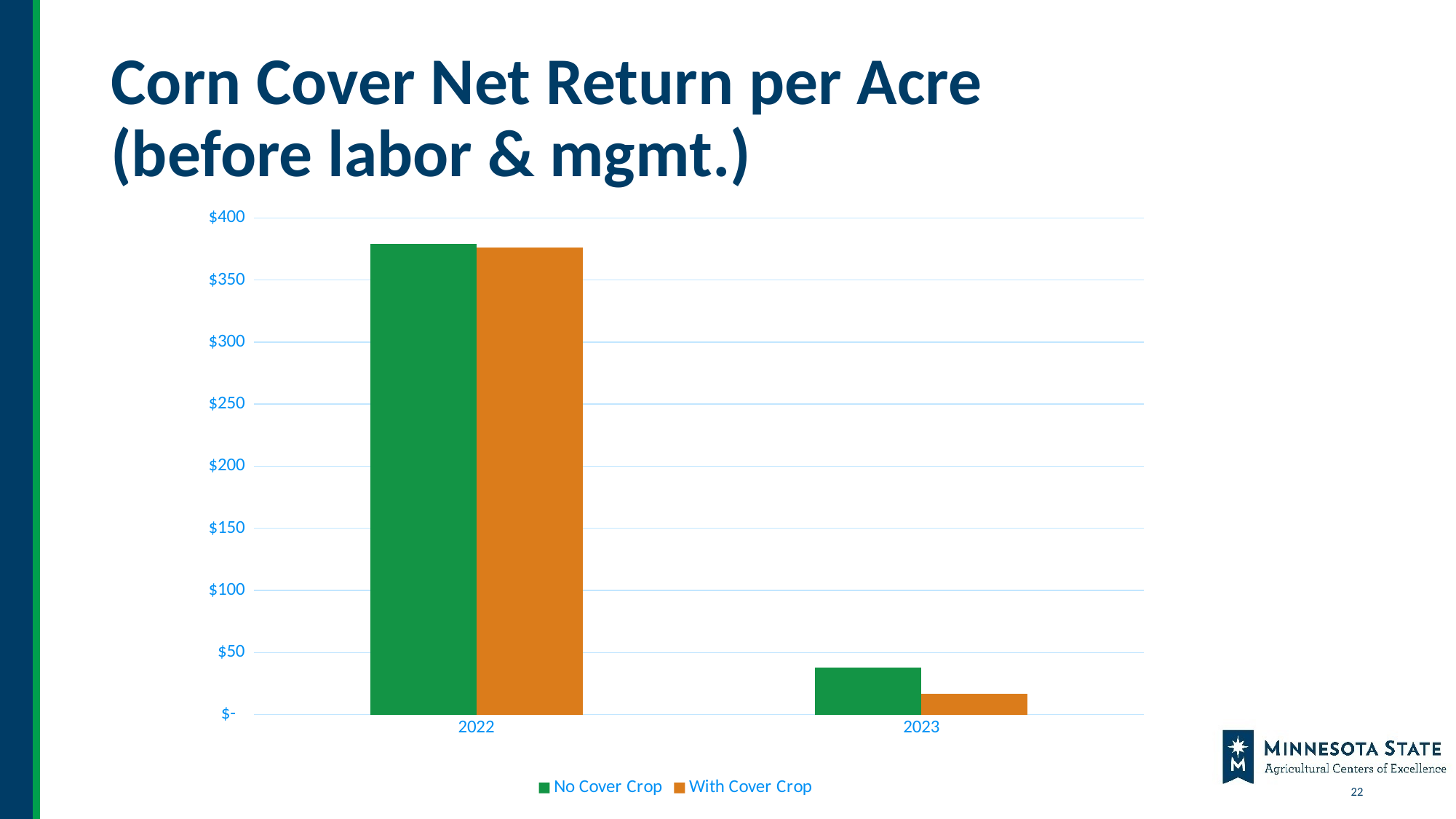
In 2023, which is larger: No Cover Crop or With Cover Crop? No Cover Crop Is the value for No Cover Crop in 2022 greater or less than $350? greater Do the No Cover Crop values rise or fall from 2022 to 2023? fall Is the value for No Cover Crop in 2023 greater or less than $50? less Which colour represents With Cover Crop in the legend? orange Is the value for With Cover Crop in 2023 greater or less than $50? less What kind of chart is shown on the slide? bar chart How many series does the legend list? 2 For With Cover Crop, which year has the larger value: 2022 or 2023? 2022 Which bar has the lowest value on the chart? With Cover Crop in 2023 How many year categories are shown on the x axis? 2